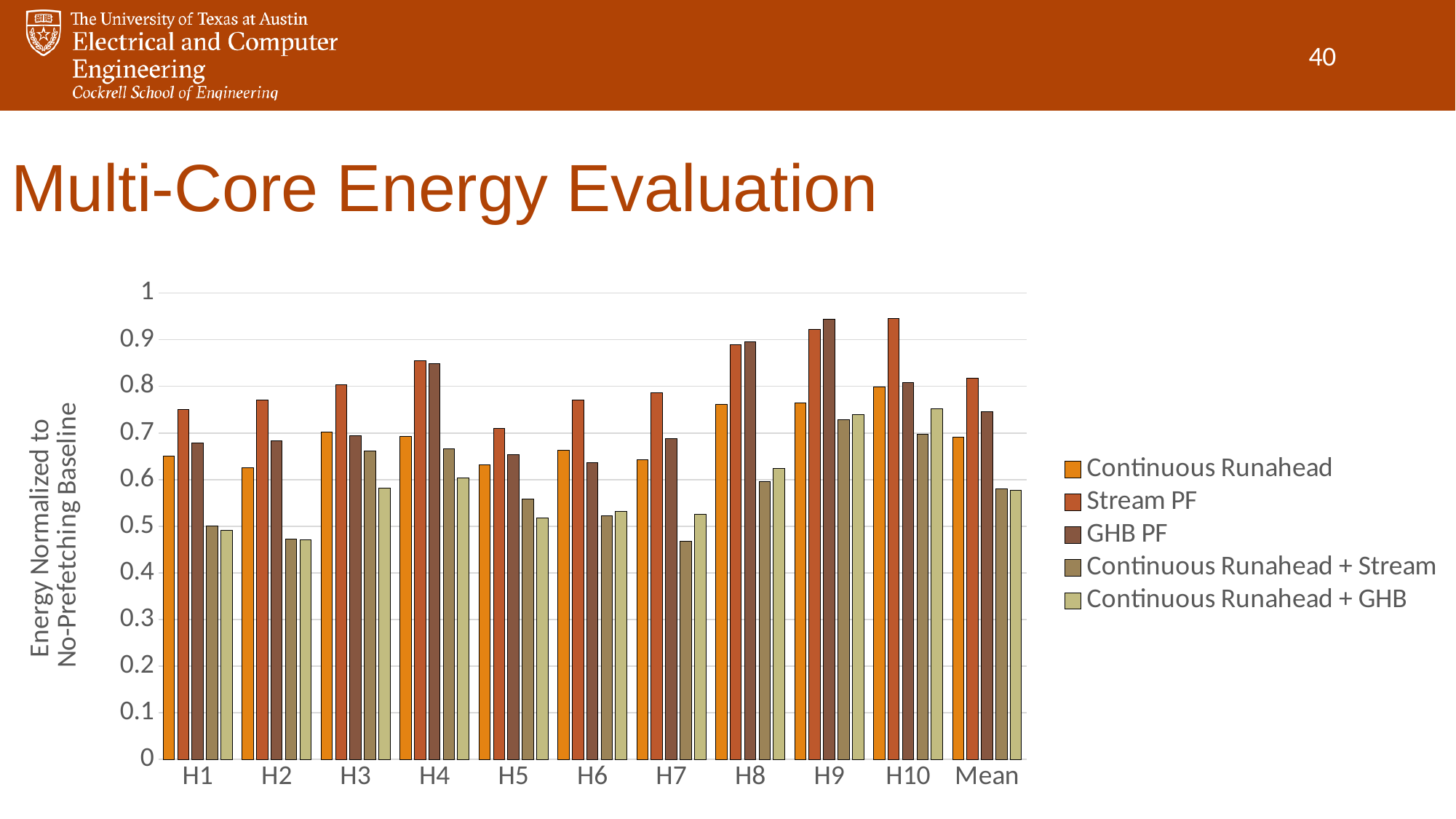
Is the Stream PF value for H9 greater or less than 0.9? greater Which category has the highest Stream PF bar? H10 What is the label on the y axis? Energy Normalized to No-Prefetching Baseline Is the Stream PF value for H4 greater or less than 0.8? greater For H3, which is larger: Continuous Runahead + Stream or Continuous Runahead + GHB? Continuous Runahead + Stream Is the Continuous Runahead + Stream value for H7 greater or less than 0.5? less For H8, which is larger: Stream PF or Continuous Runahead? Stream PF What kind of chart is shown on the slide? bar chart How many categories are shown along the x axis? 11 Which category has the lowest Stream PF bar? H5 How many series does the legend list? 5